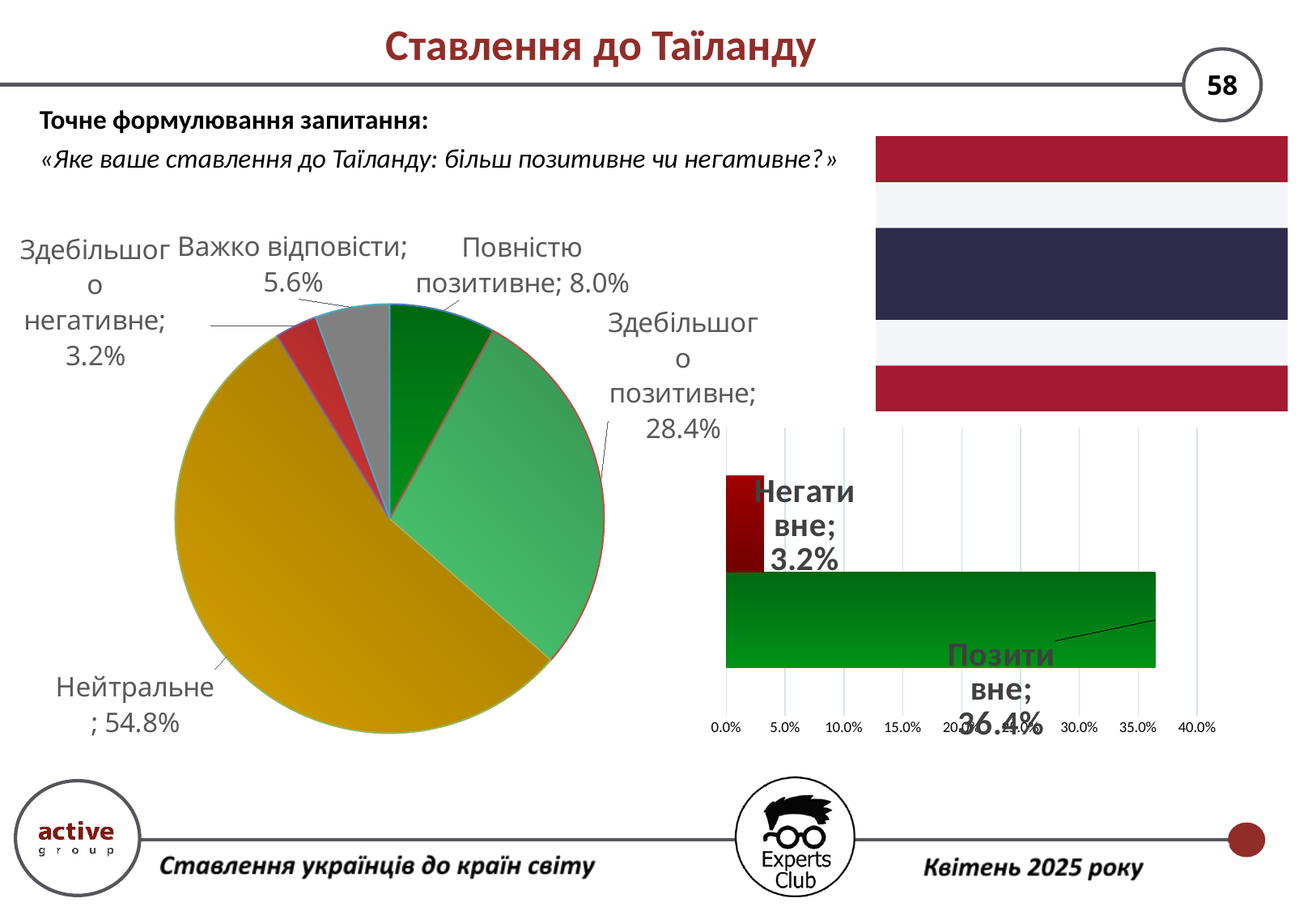
What type of chart is shown on the right side of the slide? Bar chart On the pie chart, which category has the largest share? Нейтральне On the pie chart, which is larger: "Важко відповісти" or "Здебільшого негативне"? Важко відповісти On the pie chart, how many categories are shown? 5 On the bar chart on the right, what is the value for "Негативне"? 3.2% On the pie chart, what is the value for "Повністю позитивне"? 8.0% On the pie chart, what share of respondents answered "Нейтральне"? 54.8% On the pie chart, what is the difference between "Здебільшого позитивне" and "Повністю позитивне"? 20.4% On the bar chart on the right, what is the difference between "Позитивне" and "Негативне"? 33.2% On the pie chart, which category has the smallest share? Здебільшого негативне On the pie chart, what is the value for "Здебільшого позитивне"? 28.4% On the bar chart on the right, what is the value for "Позитивне"? 36.4%